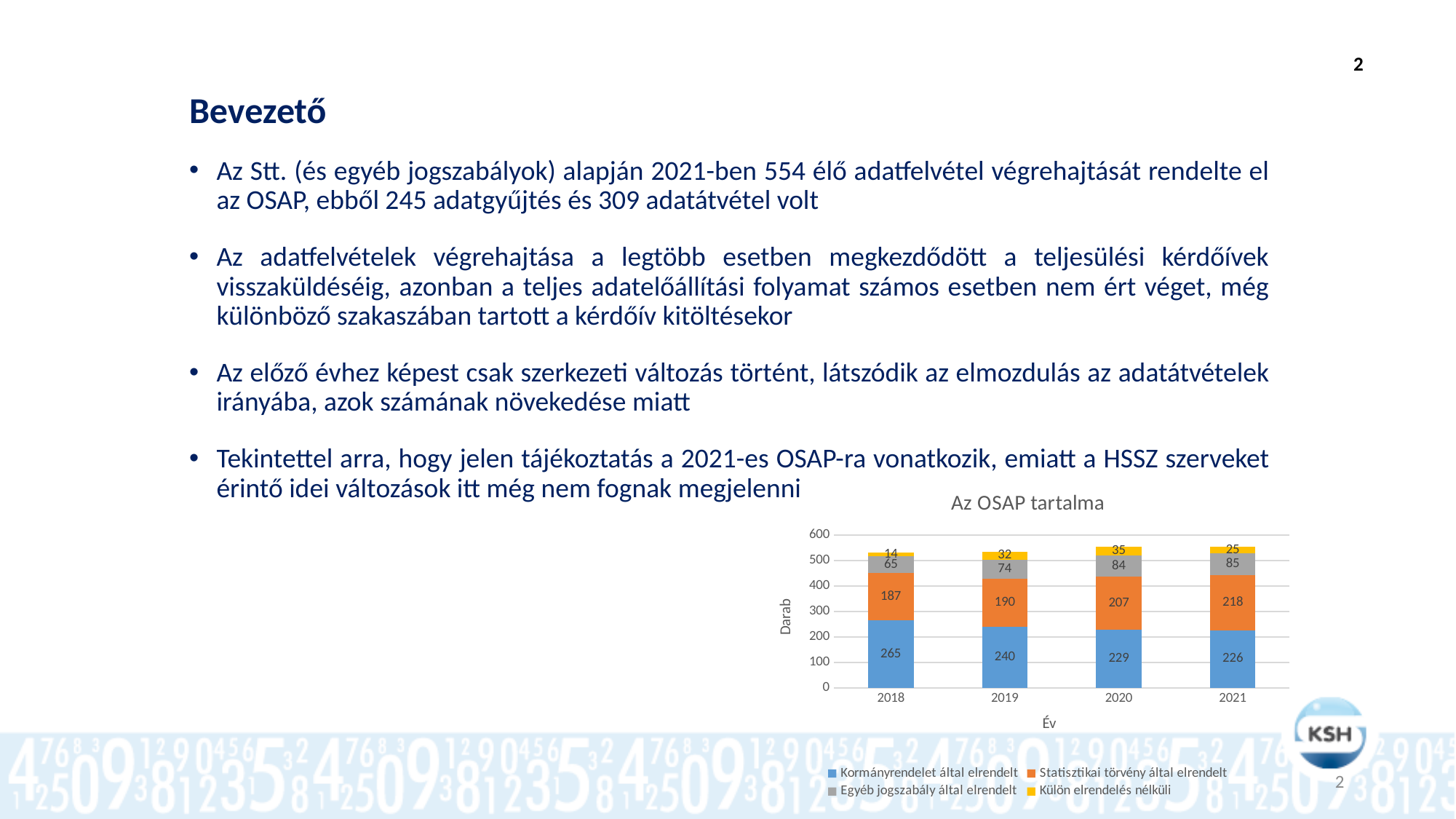
In the chart "Az OSAP tartalma", what is the value for Egyéb jogszabály által elrendelt in 2020? 84 In the chart "Az OSAP tartalma", does the Kormányrendelet által elrendelt value rise or fall from 2018 to 2021? fall What kind of chart is "Az OSAP tartalma"? stacked bar chart How many series does the legend of the chart "Az OSAP tartalma" list? 4 In the chart "Az OSAP tartalma", what is the total of the stacked bar for 2021? 554 In the chart "Az OSAP tartalma", what is the value for Kormányrendelet által elrendelt in 2018? 265 In the chart "Az OSAP tartalma", what is the difference between the Statisztikai törvény által elrendelt values for 2021 and 2018? 31 In the chart "Az OSAP tartalma", what is the value for Statisztikai törvény által elrendelt in 2021? 218 In the chart "Az OSAP tartalma", which is larger in 2020: Kormányrendelet által elrendelt or Statisztikai törvény által elrendelt? Kormányrendelet által elrendelt In the chart "Az OSAP tartalma", what is the value for Külön elrendelés nélküli in 2019? 32 In the chart "Az OSAP tartalma", which year has the lowest value for Külön elrendelés nélküli? 2018 In the chart "Az OSAP tartalma", which year has the highest value for Kormányrendelet által elrendelt? 2018